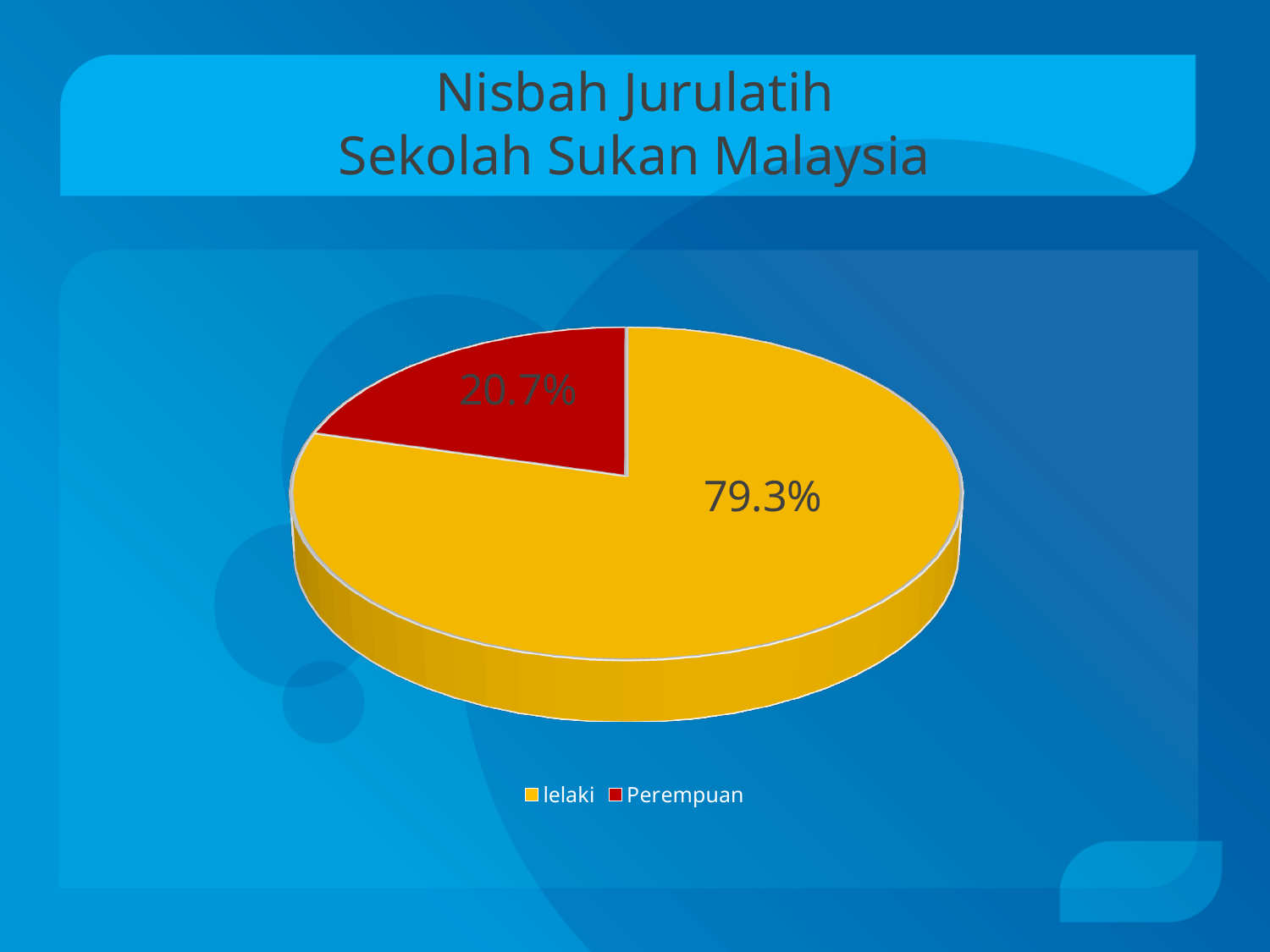
What is the difference in percentage points between the lelaki slice and the Perempuan slice? 58.6 What share of the pie does lelaki represent? 79.3% Which category has the largest slice of the pie? lelaki How many slices does the pie chart have? 2 What share of the pie does Perempuan represent? 20.7% What is the title of the chart? Nisbah Jurulatih Sekolah Sukan Malaysia What colour is the Perempuan slice? red What kind of chart is shown on the slide? pie chart Which category has the smallest slice of the pie? Perempuan Which is larger, the slice for lelaki or the slice for Perempuan? lelaki How many entries does the legend list? 2